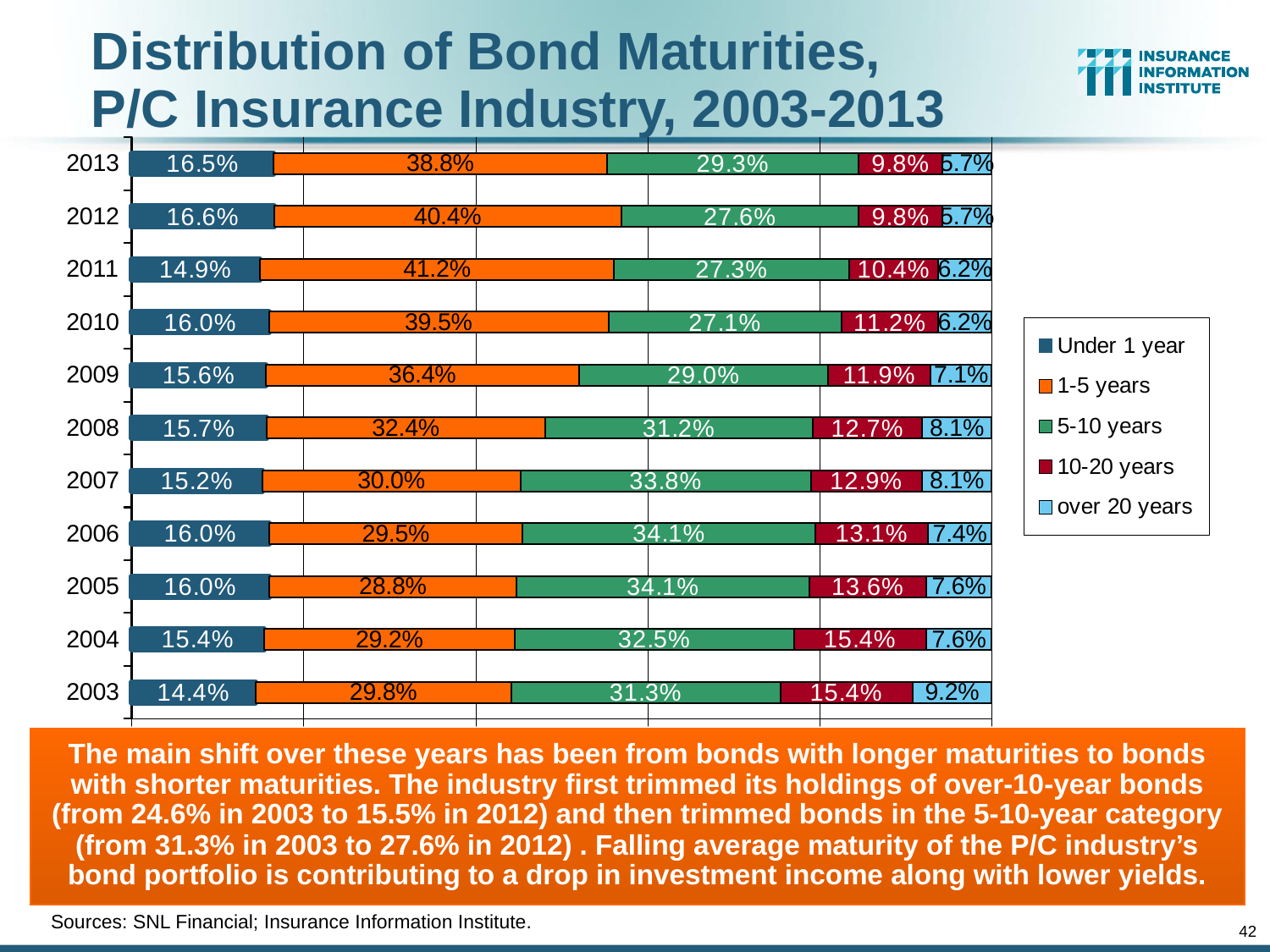
What is the share of bonds with 1-5 years maturity in 2013? 38.8% What kind of chart is shown on the slide? Stacked bar chart How many years are shown on the chart? 11 In which year is the 1-5 years share the highest? 2011 How does the 10-20 years share change from 2003 to 2013? It falls How many series does the legend list? 5 In which year is the Under 1 year share the lowest? 2003 What is the share of bonds with over 20 years maturity in 2003? 9.2% What is the share of bonds with 5-10 years maturity in 2007? 33.8% Which legend entry is shown in orange? 1-5 years Which is larger in 2009: the 1-5 years share or the 5-10 years share? 1-5 years What is the difference between the 10-20 years share in 2003 and in 2013? 5.6%